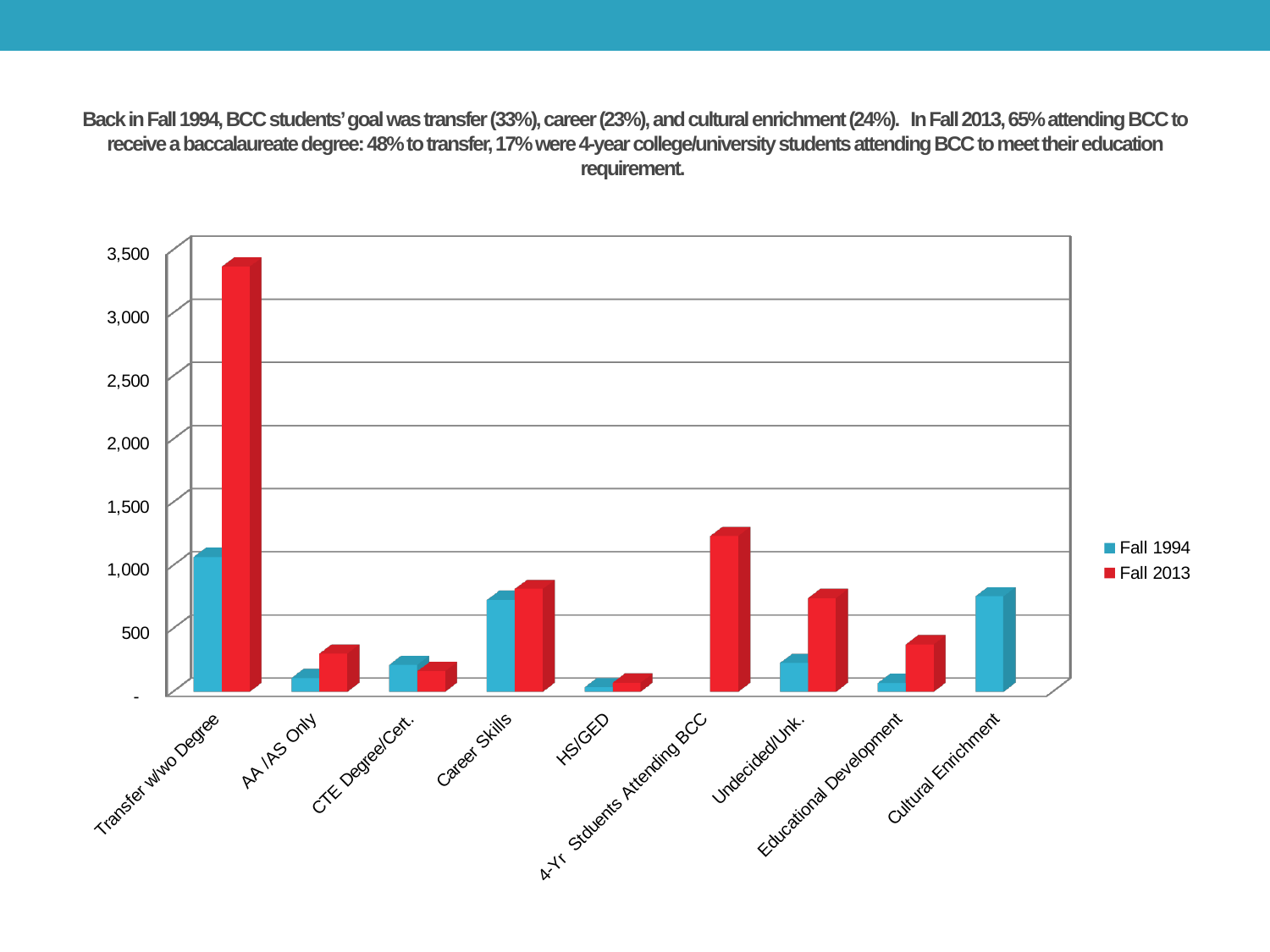
For Transfer w/wo Degree, which is larger: the Fall 1994 value or the Fall 2013 value? Fall 2013 Is the Fall 2013 value for 4-Yr Students Attending BCC greater or less than 1,000? greater Which category has the highest Fall 2013 value? Transfer w/wo Degree What kind of chart is shown on the slide? bar chart Is the Fall 2013 value for Transfer w/wo Degree greater or less than 3,000? greater How many series does the legend list? 2 For Undecided/Unk., which is larger: the Fall 1994 value or the Fall 2013 value? Fall 2013 Is the Fall 1994 value for Cultural Enrichment greater or less than 500? greater Which category has the highest Fall 1994 value? Transfer w/wo Degree How many categories are shown on the x axis? 9 Which series is shown in red in the legend? Fall 2013